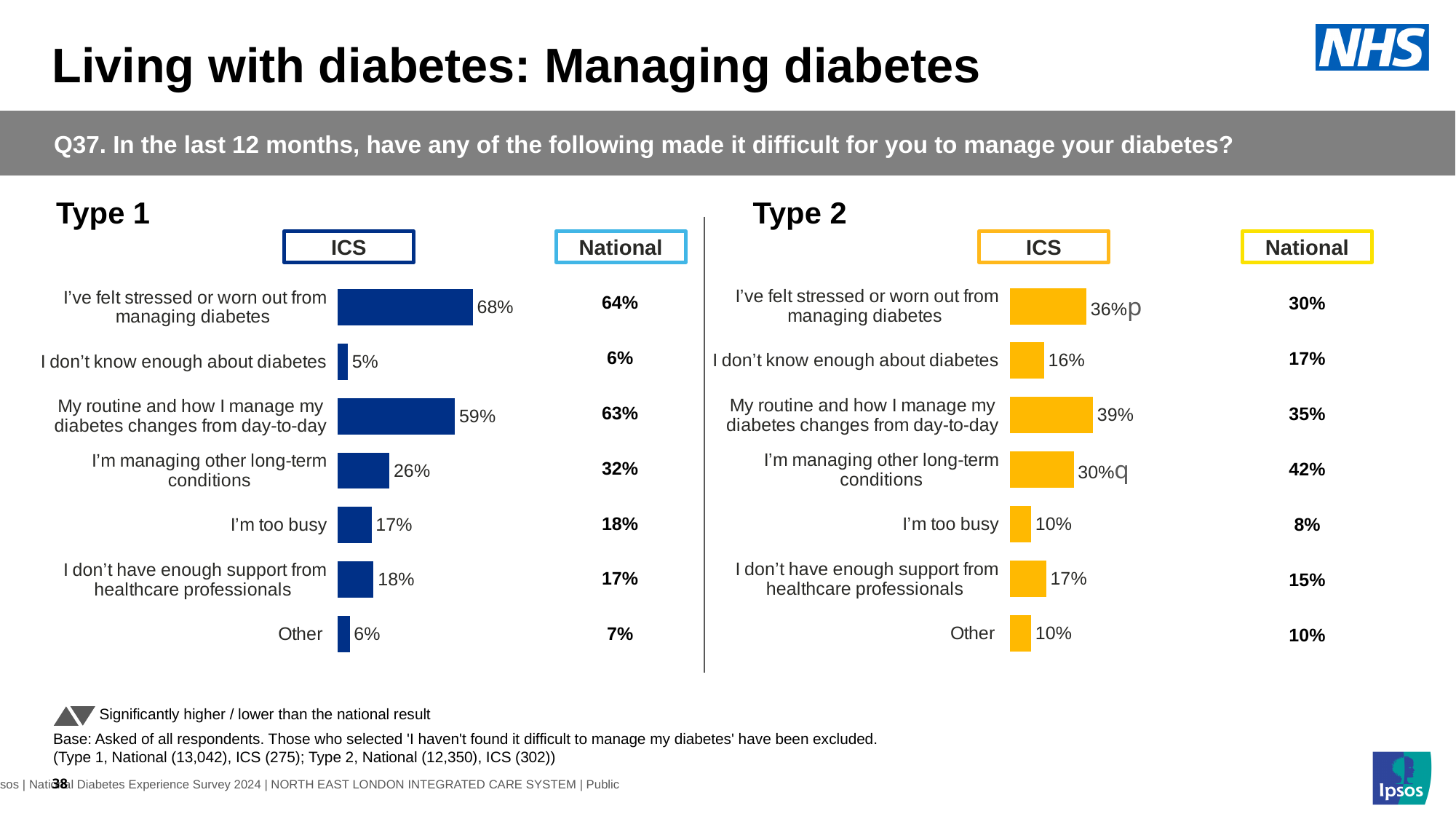
In the Type 1 chart, is the ICS value for 'My routine and how I manage my diabetes changes from day-to-day' larger or smaller than the National value? smaller In the Type 2 chart, what is the National value for 'I'm managing other long-term conditions'? 42% How many categories are shown in the Type 1 chart? 7 In the Type 1 chart, which category has the lowest ICS value? I don't know enough about diabetes In the Type 1 chart, which category has the highest ICS value? I've felt stressed or worn out from managing diabetes In the Type 1 chart, what is the difference between the ICS and National values for 'I'm managing other long-term conditions'? 6 percentage points In the Type 2 chart, what is the difference between the ICS and National values for 'I've felt stressed or worn out from managing diabetes'? 6 percentage points In the Type 2 chart, what is the ICS value for 'My routine and how I manage my diabetes changes from day-to-day'? 39% What kind of chart is used for the ICS values in the Type 2 chart? bar chart In the Type 2 chart, which category has the lowest National value? I'm too busy In the Type 2 chart, is the ICS value for 'I'm managing other long-term conditions' larger or smaller than the National value? smaller In the Type 1 chart, what is the ICS value for 'I've felt stressed or worn out from managing diabetes'? 68%